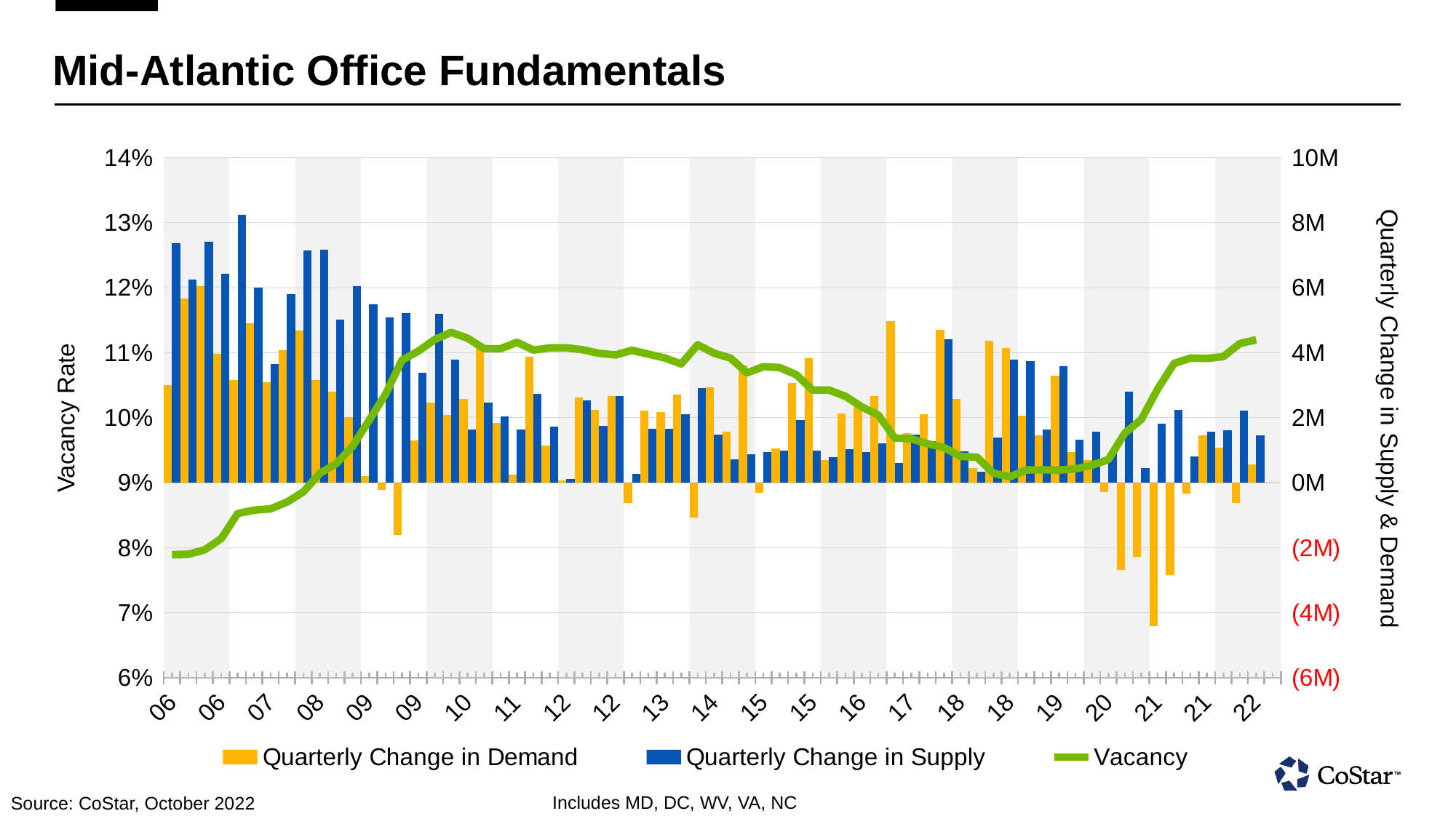
Is the tallest Quarterly Change in Supply bar, in 2006, greater or less than 6M? greater In which year does the Quarterly Change in Demand reach its lowest (most negative) value? 2021 What kind of chart is shown on the slide? A combination bar and line chart How many series does the legend list? 3 Is the Vacancy rate at its 2018 low point greater or less than 10%? less Which series is plotted as a line rather than bars? Vacancy What is the label of the left vertical axis? Vacancy Rate Does the Vacancy line rise or fall between 2006 and 2010? Rises Is the Vacancy rate at the end of 2022 greater or less than 10%? greater Does the Vacancy line rise or fall between 2020 and 2022? Rises Does the Vacancy line rise or fall between 2014 and 2018? Falls